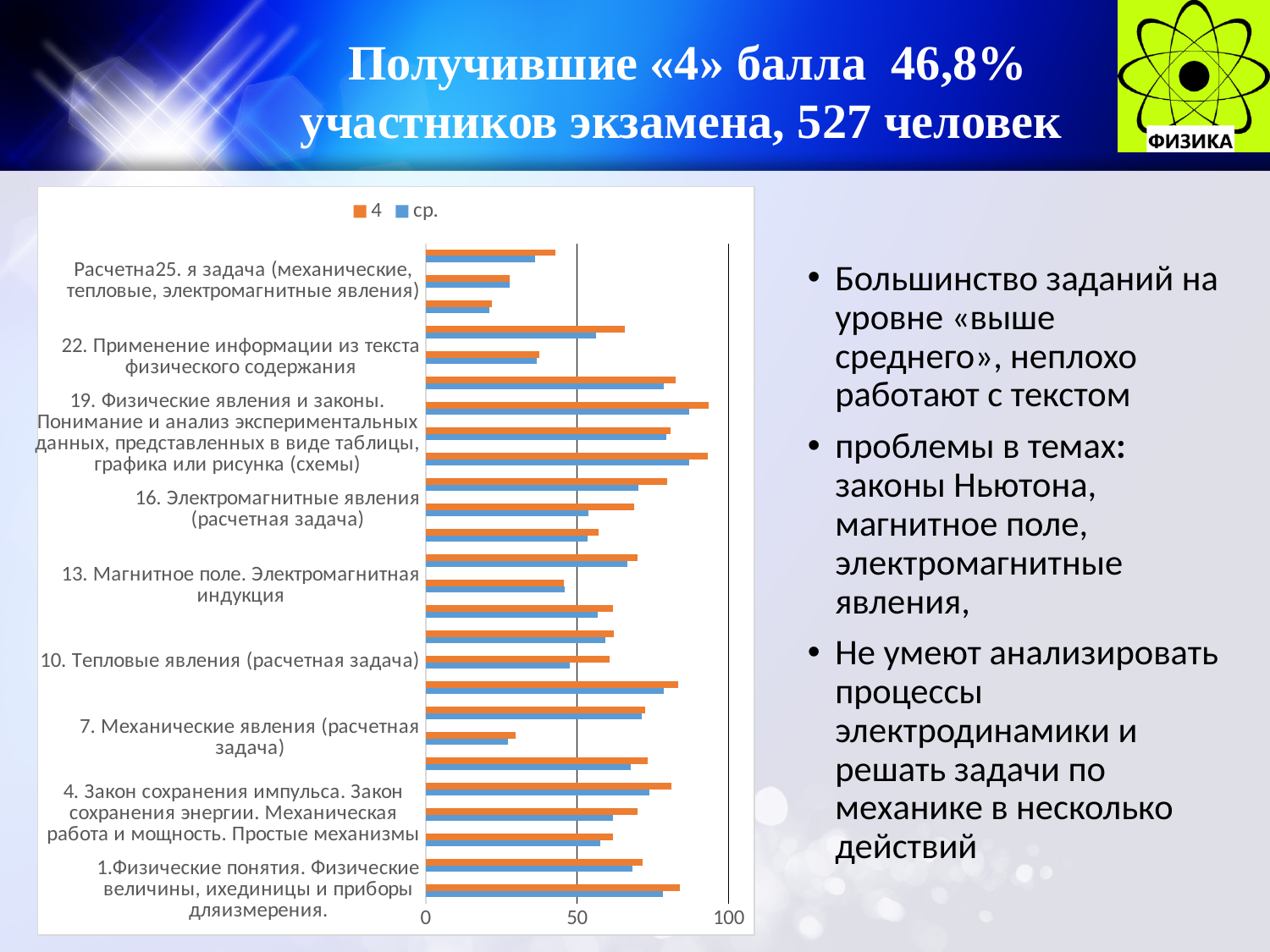
What are the two series named in the chart legend? 4 and ср. Is the value of series "4" for "7. Механические явления (расчетная задача)" greater or less than 50? less What kind of chart is shown on the slide? bar chart For series "4", which is larger: the value for "1.Физические понятия..." or the value for "7. Механические явления (расчетная задача)"? 1.Физические понятия... For "10. Тепловые явления (расчетная задача)", which series has the larger value: "4" or "ср."? 4 Which colour represents the series "4" in the chart? orange Is the value of series "4" for "19. Физические явления и законы. Понимание и анализ экспериментальных данных..." greater or less than 50? greater For "16. Электромагнитные явления (расчетная задача)", which series has the larger value: "4" or "ср."? 4 Is the value of series "4" for "1.Физические понятия. Физические величины, их единицы и приборы для измерения" greater or less than 50? greater How many series does the chart legend list? 2